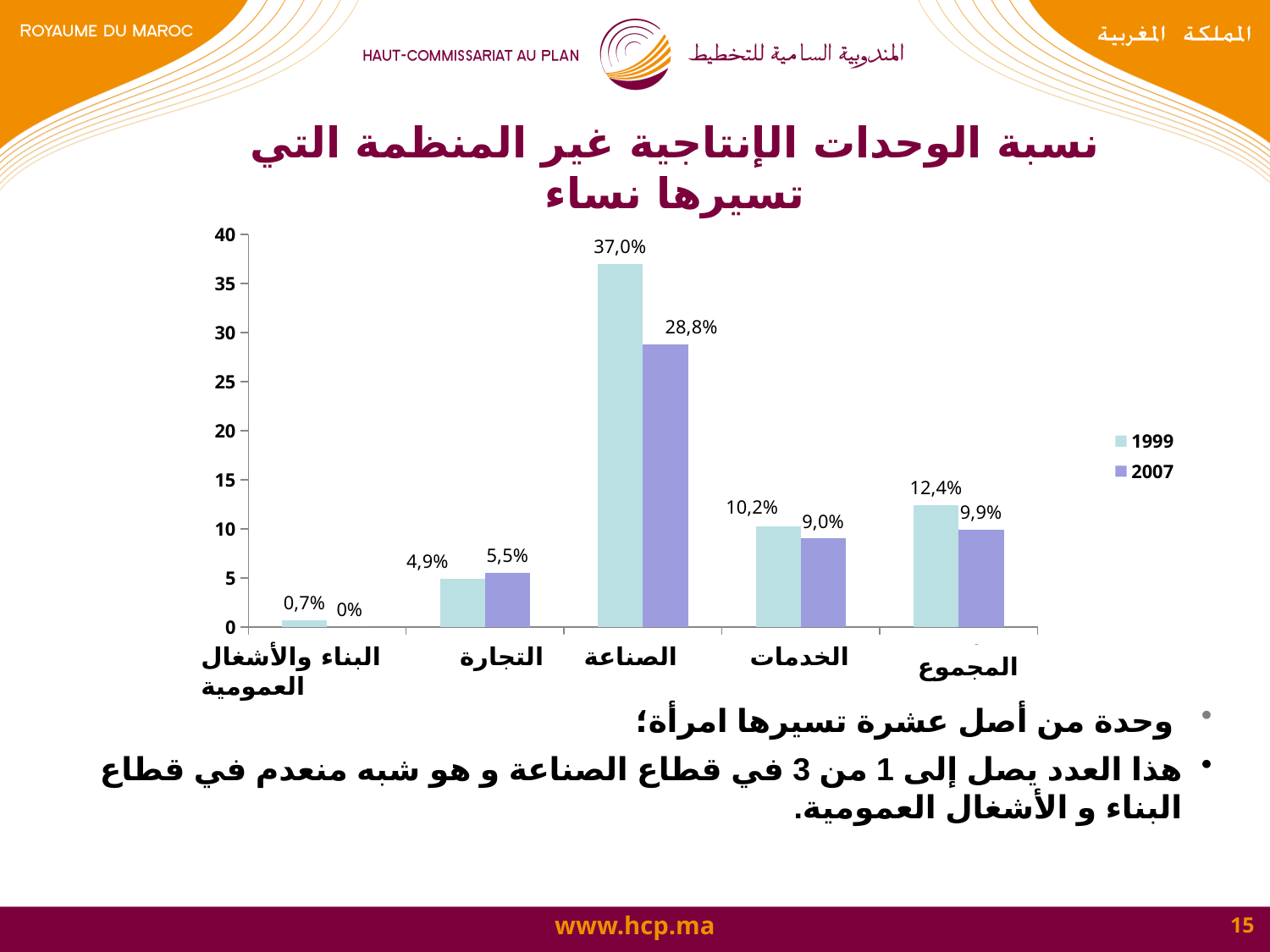
How many categories are shown on the x axis? 5 Which category has the lowest value in the 2007 series? البناء والأشغال العمومية How many series does the legend list? 2 What are the two series listed in the legend? 1999 and 2007 Which is larger for التجارة: the 1999 value or the 2007 value? 2007 What is the value for التجارة in the 2007 series? 5,5% What is the value for المجموع in the 1999 series? 12,4% What kind of chart is shown on the slide? bar chart What is the value for الصناعة in the 2007 series? 28,8% What is the difference between the 1999 and 2007 values for الصناعة? 8,2% Which category has the highest value in the 1999 series? الصناعة What is the value for الصناعة in the 1999 series? 37,0%